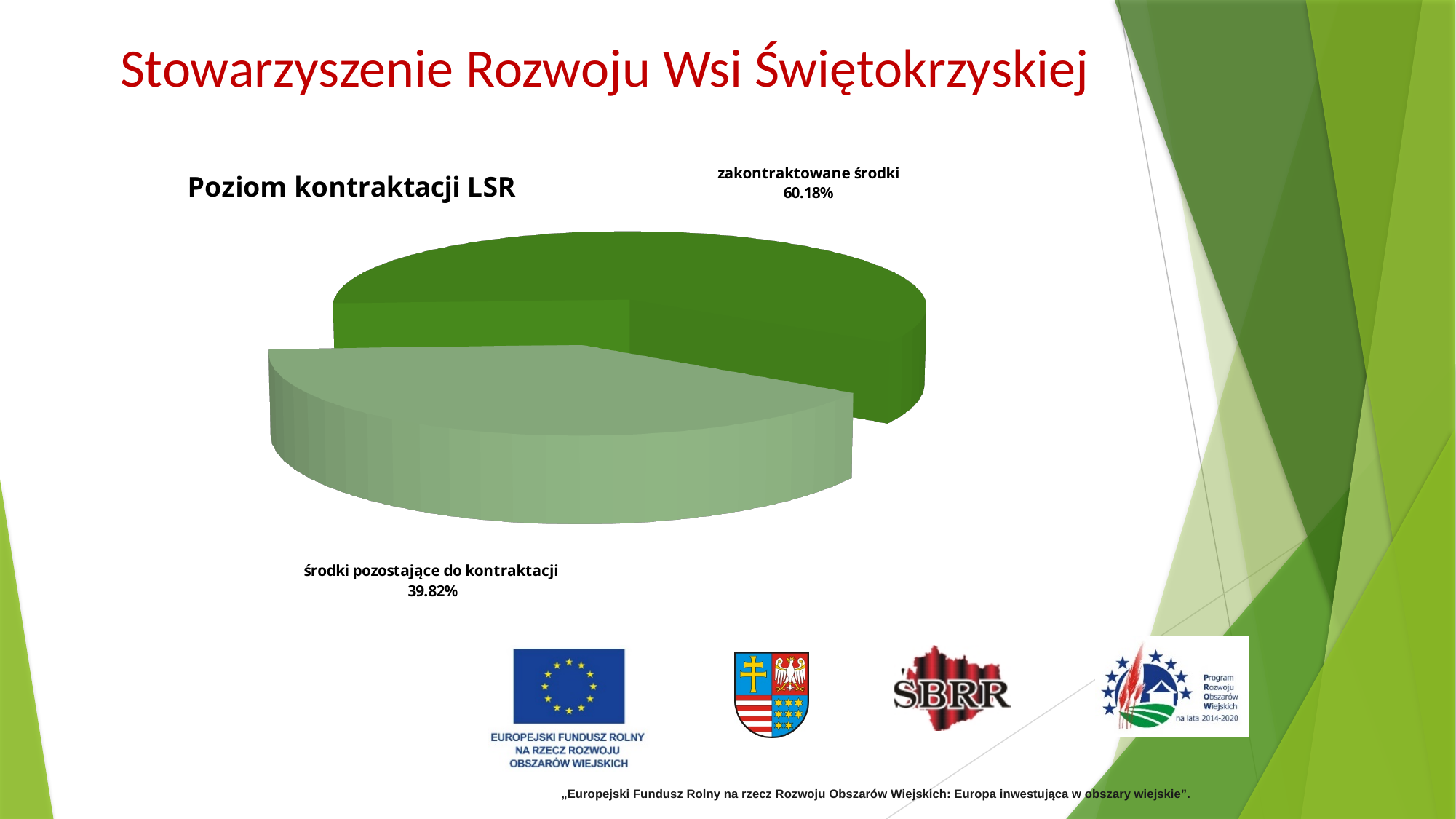
What is the total of the two slice percentages shown on the pie chart? 100% What is the difference in percentage points between "zakontraktowane środki" and "środki pozostające do kontraktacji"? 20.36 How many slices does the pie chart have? 2 What share of the pie is labelled "zakontraktowane środki"? 60.18% Is the share for "zakontraktowane środki" greater or less than 50%? greater Is the share for "środki pozostające do kontraktacji" greater or less than 50%? less Which is larger: the share for "zakontraktowane środki" or for "środki pozostające do kontraktacji"? zakontraktowane środki What kind of chart is shown on the slide? pie chart What share of the pie is labelled "środki pozostające do kontraktacji"? 39.82% Which slice of the pie is the largest? zakontraktowane środki Which slice of the pie is the smallest? środki pozostające do kontraktacji What is the title of the chart? Poziom kontraktacji LSR